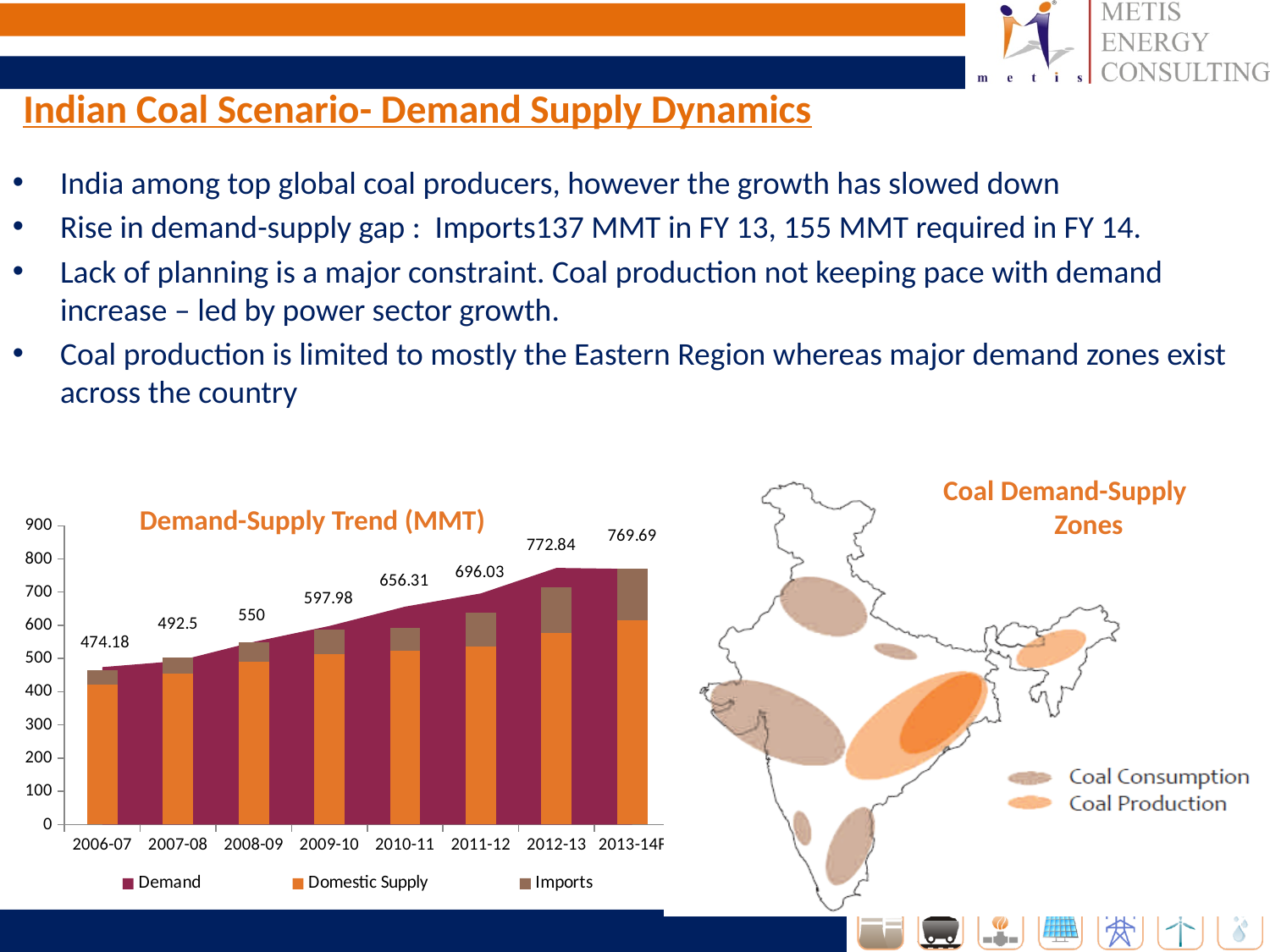
Which year has the highest Demand value in the chart? 2012-13 What is the Demand value for 2012-13 in the Demand-Supply Trend chart? 772.84 Which year has the larger Demand value, 2009-10 or 2010-11? 2010-11 How many series does the legend of the Demand-Supply Trend chart list? 3 What is the Demand value for 2006-07 in the Demand-Supply Trend chart? 474.18 Does the Demand value rise or fall from 2006-07 to 2012-13? rise Is the Domestic Supply value for 2006-07 greater or less than 500? less Which year has the lowest Demand value in the chart? 2006-07 What is the Demand value for 2009-10? 597.98 How many years are shown on the x axis of the Demand-Supply Trend chart? 8 What kind of chart is used to show Domestic Supply and Imports? bar chart What is the difference between the Demand values for 2012-13 and 2006-07? 298.66